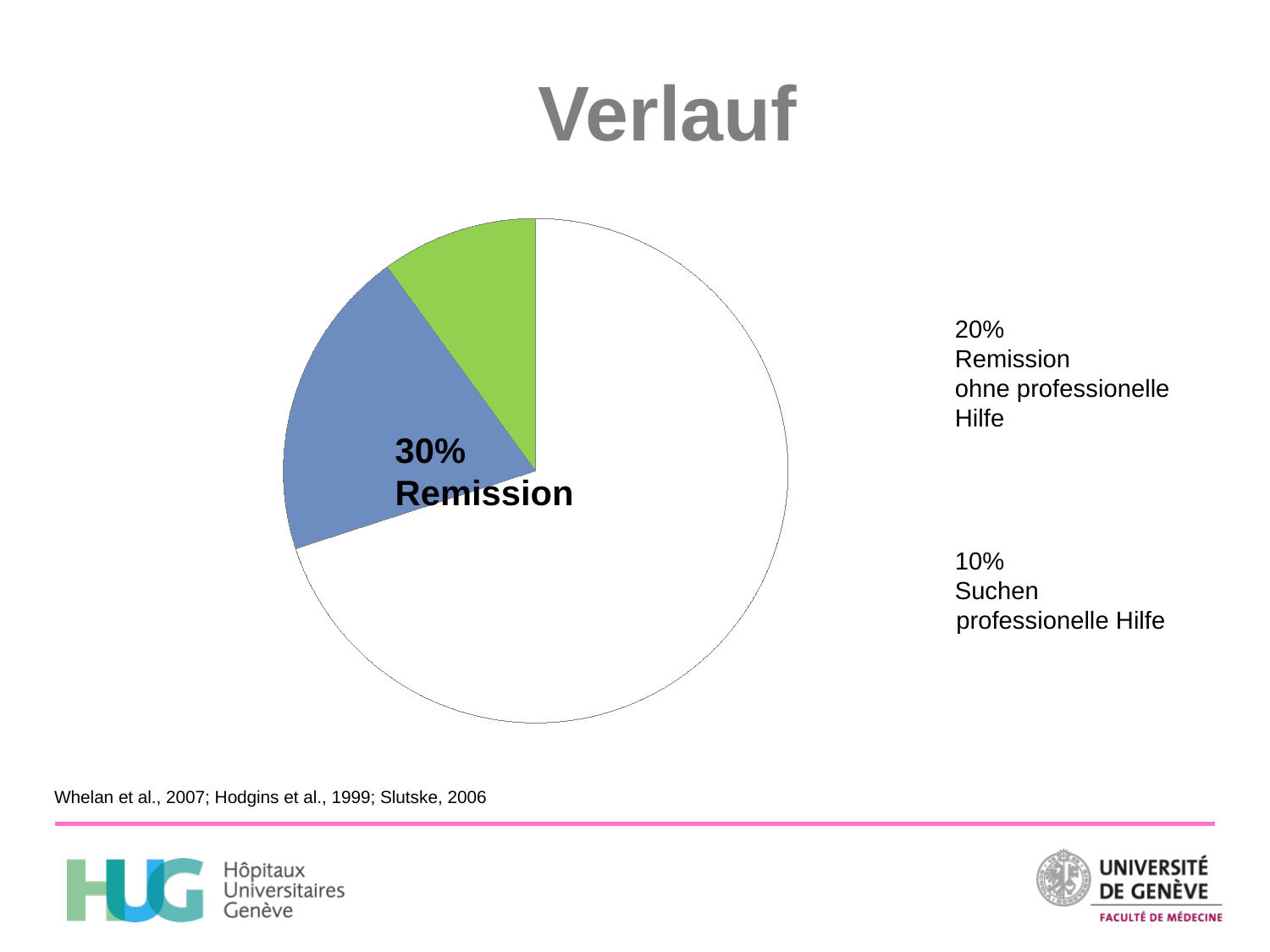
Is the share of the large unlabelled white slice greater or less than 50%? greater What is the combined share of the two coloured slices (Remission ohne professionelle Hilfe and Suchen professionelle Hilfe)? 30% Which is larger: the share for 'Remission ohne professionelle Hilfe' or the share for 'Suchen professionelle Hilfe'? Remission ohne professionelle Hilfe What share of the pie is labelled 'Suchen professionelle Hilfe'? 10% Of the two labelled slices, which has the smaller share? Suchen professionelle Hilfe What share of the pie is labelled 'Remission ohne professionelle Hilfe'? 20% What is the title of the slide containing the pie chart? Verlauf What colour is the slice for 'Suchen professionelle Hilfe'? green What kind of chart is shown on the slide? pie chart What percentage is printed inside the pie next to the word 'Remission'? 30% What is the difference between the share for 'Remission ohne professionelle Hilfe' and the share for 'Suchen professionelle Hilfe'? 10% How many slices does the pie chart have? 3